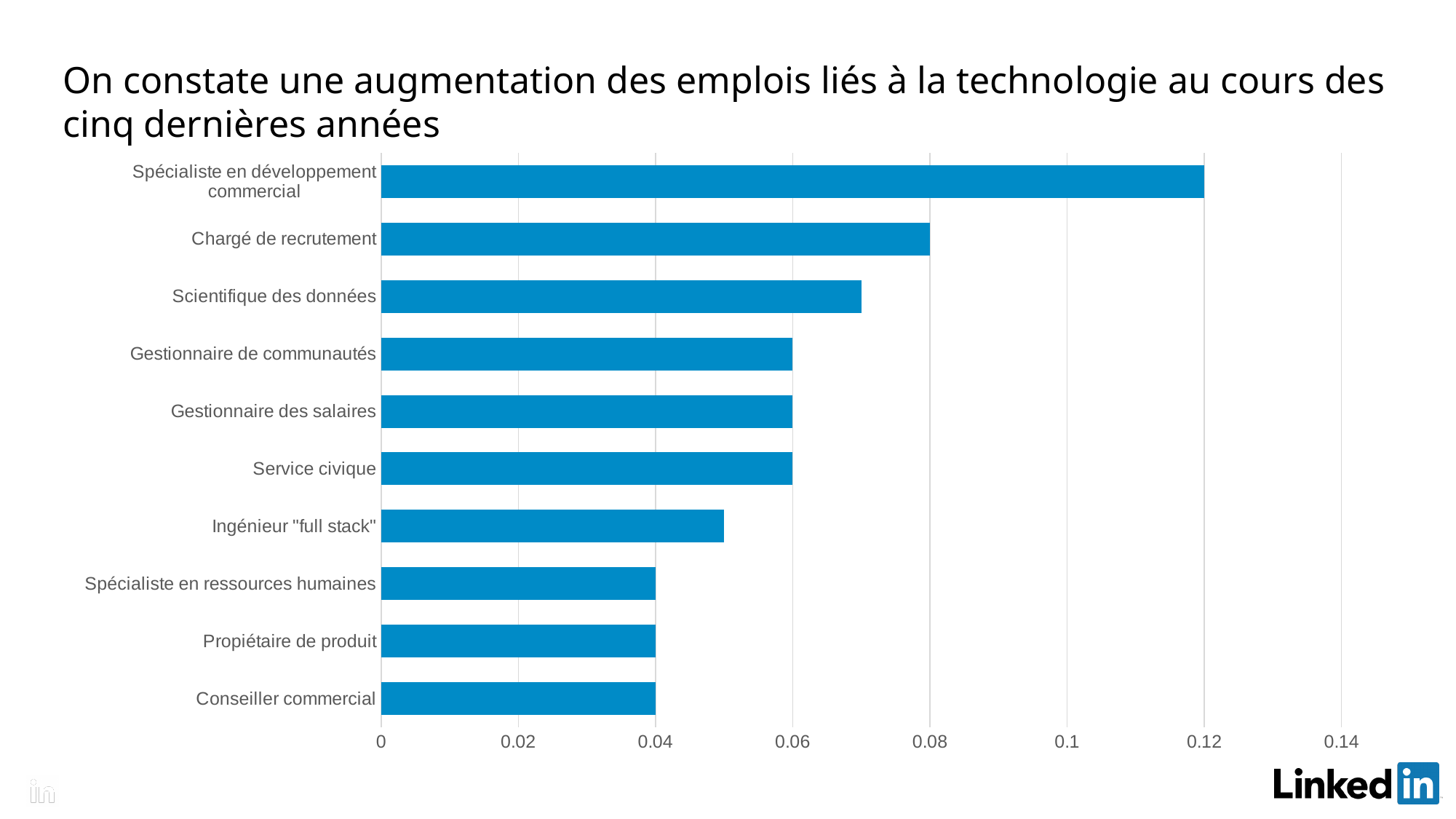
What is the value for Conseiller commercial? 0.04 What is the title of the slide? On constate une augmentation des emplois liés à la technologie au cours des cinq dernières années What is the value for Chargé de recrutement? 0.08 Is the value for Ingénieur "full stack" greater or less than 0.06? less How many job categories are shown in the chart? 10 What is the value for Spécialiste en développement commercial? 0.12 What type of chart is shown on the slide? Bar chart What is the difference between the values for Spécialiste en développement commercial and Chargé de recrutement? 0.04 What is the value for Service civique? 0.06 Which is larger, the value for Chargé de recrutement or the value for Gestionnaire des salaires? Chargé de recrutement Is the value for Scientifique des données greater or less than 0.06? greater Which category has the highest value in the chart? Spécialiste en développement commercial